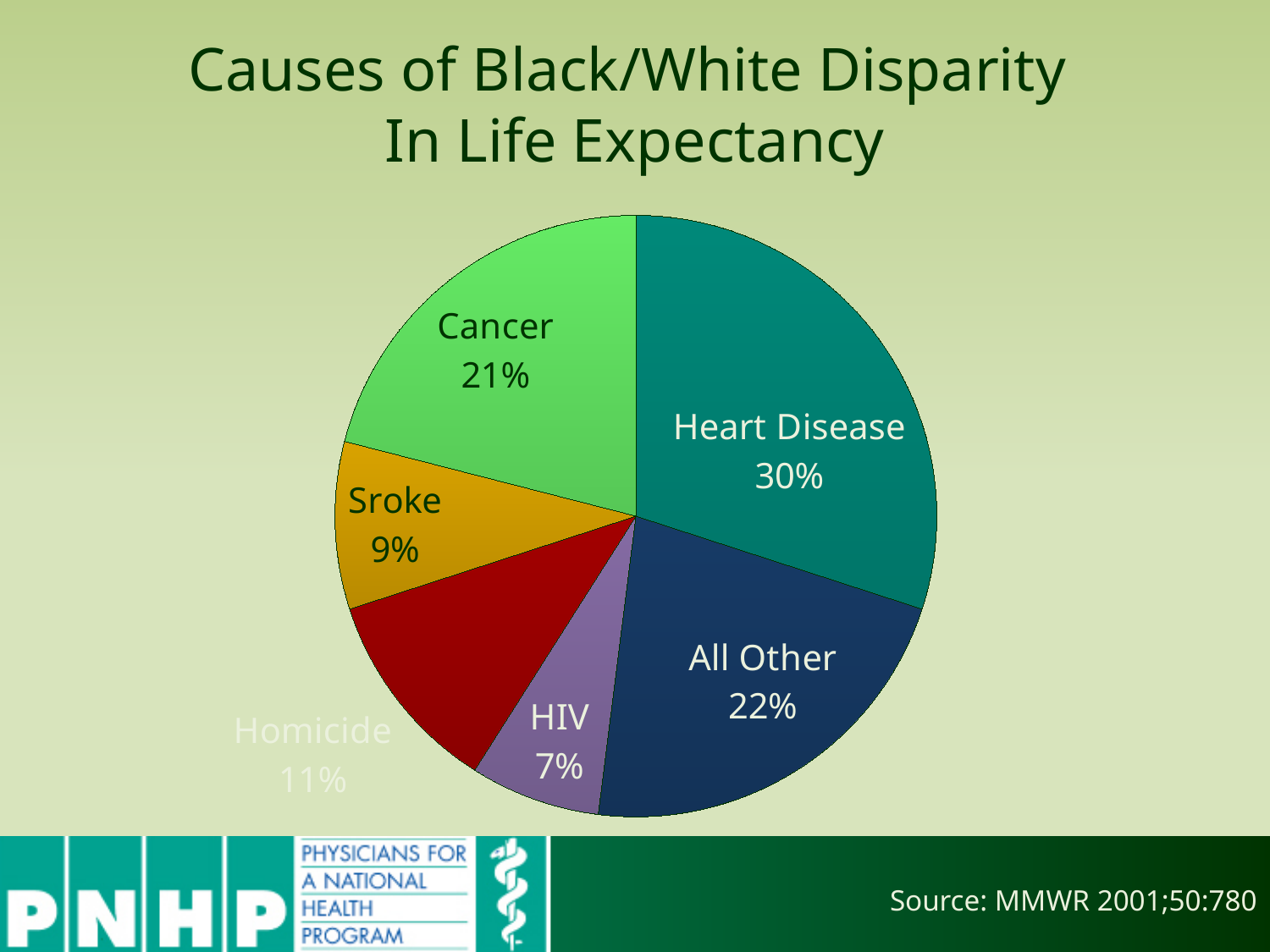
How many slices does the pie chart have? 6 What is the title of the chart on the slide? Causes of Black/White Disparity In Life Expectancy What is the difference between the Heart Disease share and the Cancer share? 9% What share of the pie is Cancer? 21% Which cause has the largest slice of the pie? Heart Disease What share of the pie is All Other? 22% What is the source cited at the bottom of the slide? MMWR 2001;50:780 Which is larger, the All Other slice or the Cancer slice? All Other What kind of chart is shown on the slide? pie chart What share of the pie is HIV? 7% Which cause has the smallest slice of the pie? HIV What share of the pie is Heart Disease? 30%